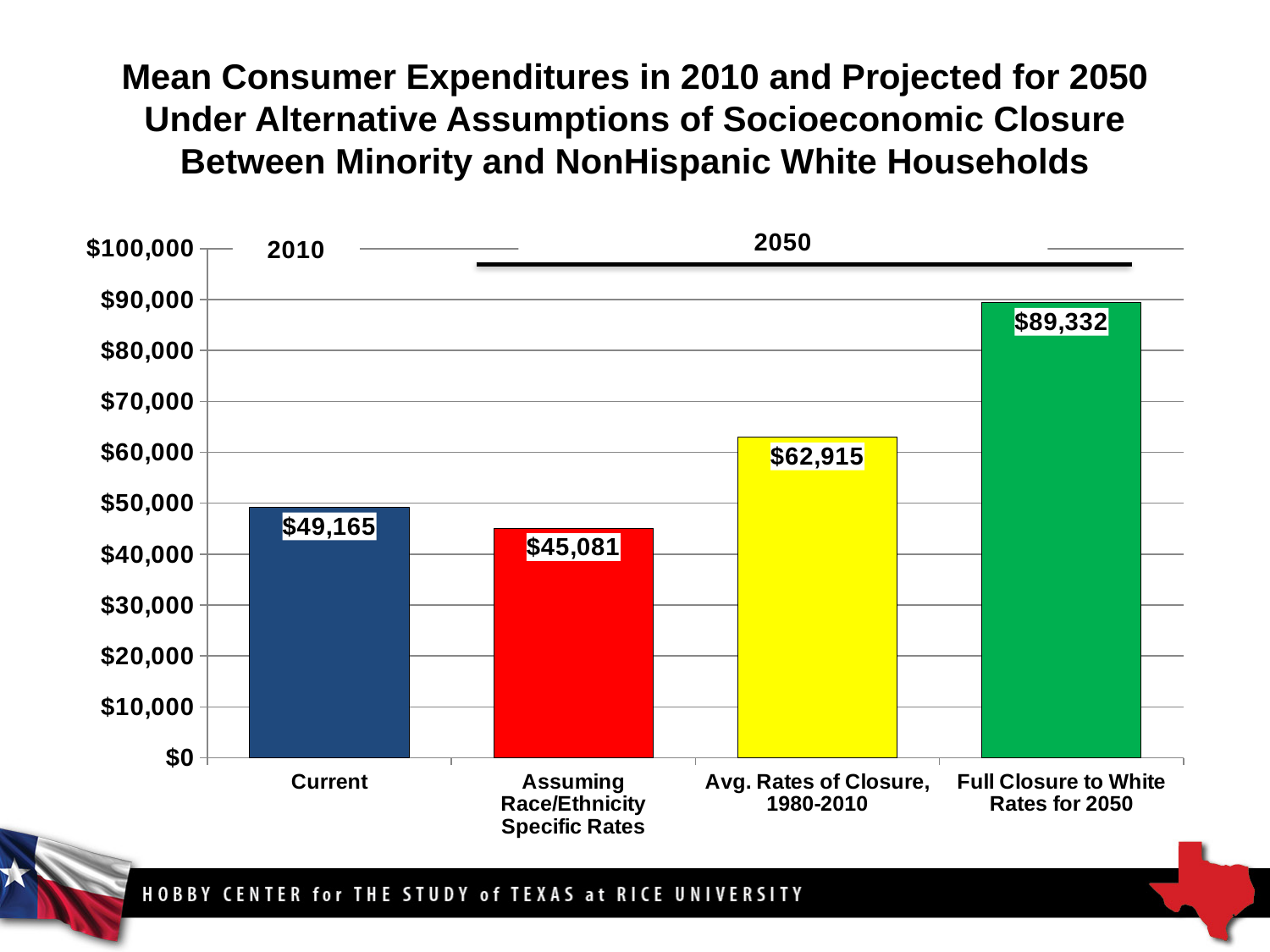
Which is larger, the value for Current or the value for Avg. Rates of Closure, 1980-2010? Avg. Rates of Closure, 1980-2010 What is the value for Avg. Rates of Closure, 1980-2010? $62,915 What is the difference between the Current value and the Assuming Race/Ethnicity Specific Rates value? $4,084 What colour is the bar for Avg. Rates of Closure, 1980-2010? Yellow Which category has the highest mean consumer expenditure? Full Closure to White Rates for 2050 What is the mean consumer expenditure for the Current category? $49,165 What is the difference between the Full Closure to White Rates for 2050 value and the Current value? $40,167 Which category has the lowest mean consumer expenditure? Assuming Race/Ethnicity Specific Rates What is the value for Assuming Race/Ethnicity Specific Rates? $45,081 What kind of chart is shown on the slide? Bar chart How many categories are shown on the chart? 4 What is the value for Full Closure to White Rates for 2050? $89,332